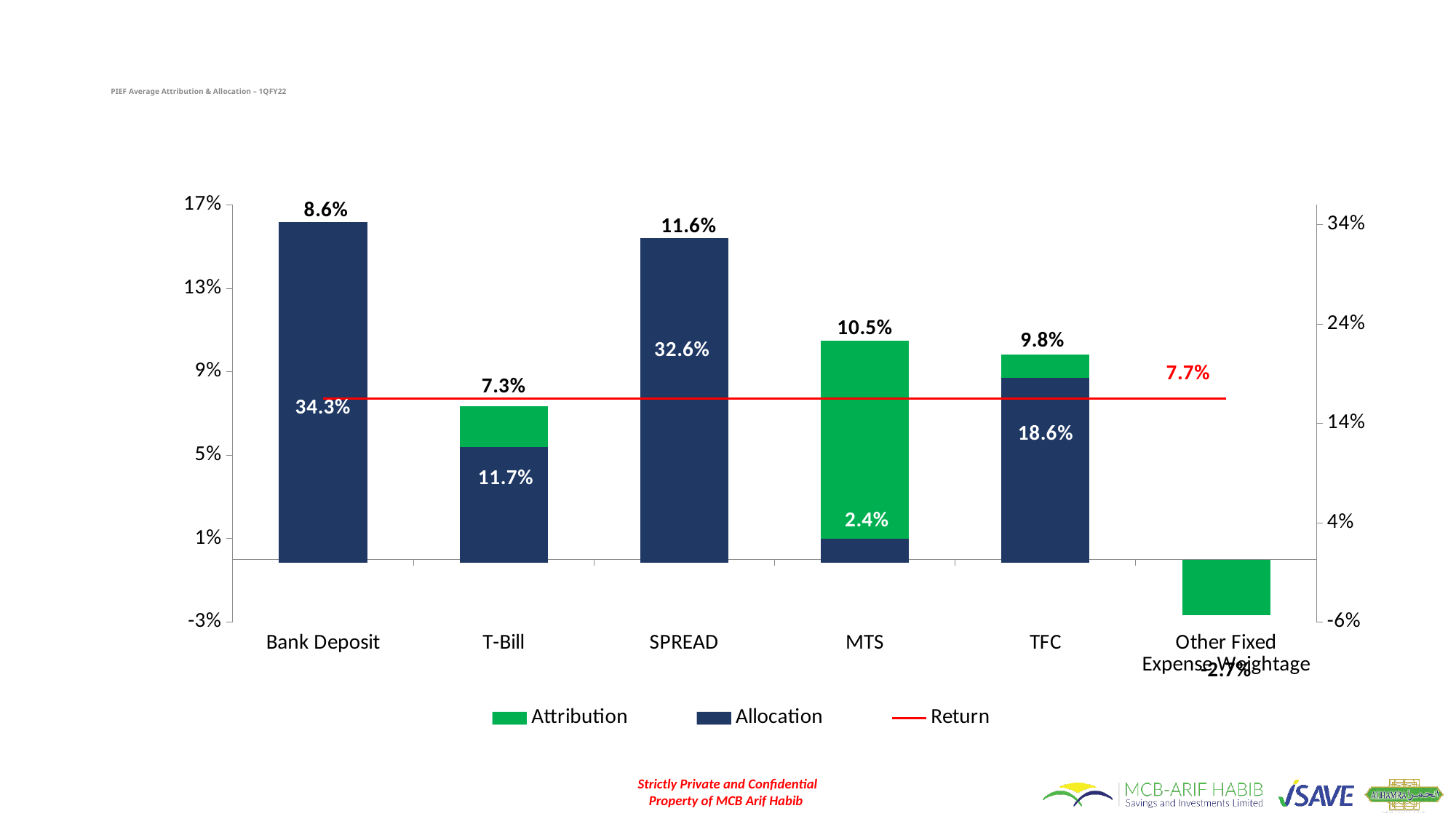
Which category has the lowest Allocation value? MTS Which category has the highest Allocation value? Bank Deposit What is the Allocation value for Bank Deposit? 34.3% Which category has the highest Attribution value? SPREAD What is the difference between the Allocation values for Bank Deposit and SPREAD? 1.7 percentage points What value is labelled on the Return line? 7.7% What is the Attribution value for MTS? 10.5% Which is larger, the Attribution value for T-Bill or for TFC? TFC What is the Attribution value for SPREAD? 11.6% How many series does the legend list? 3 How many categories are shown on the x axis? 6 What is the Allocation value for TFC? 18.6%